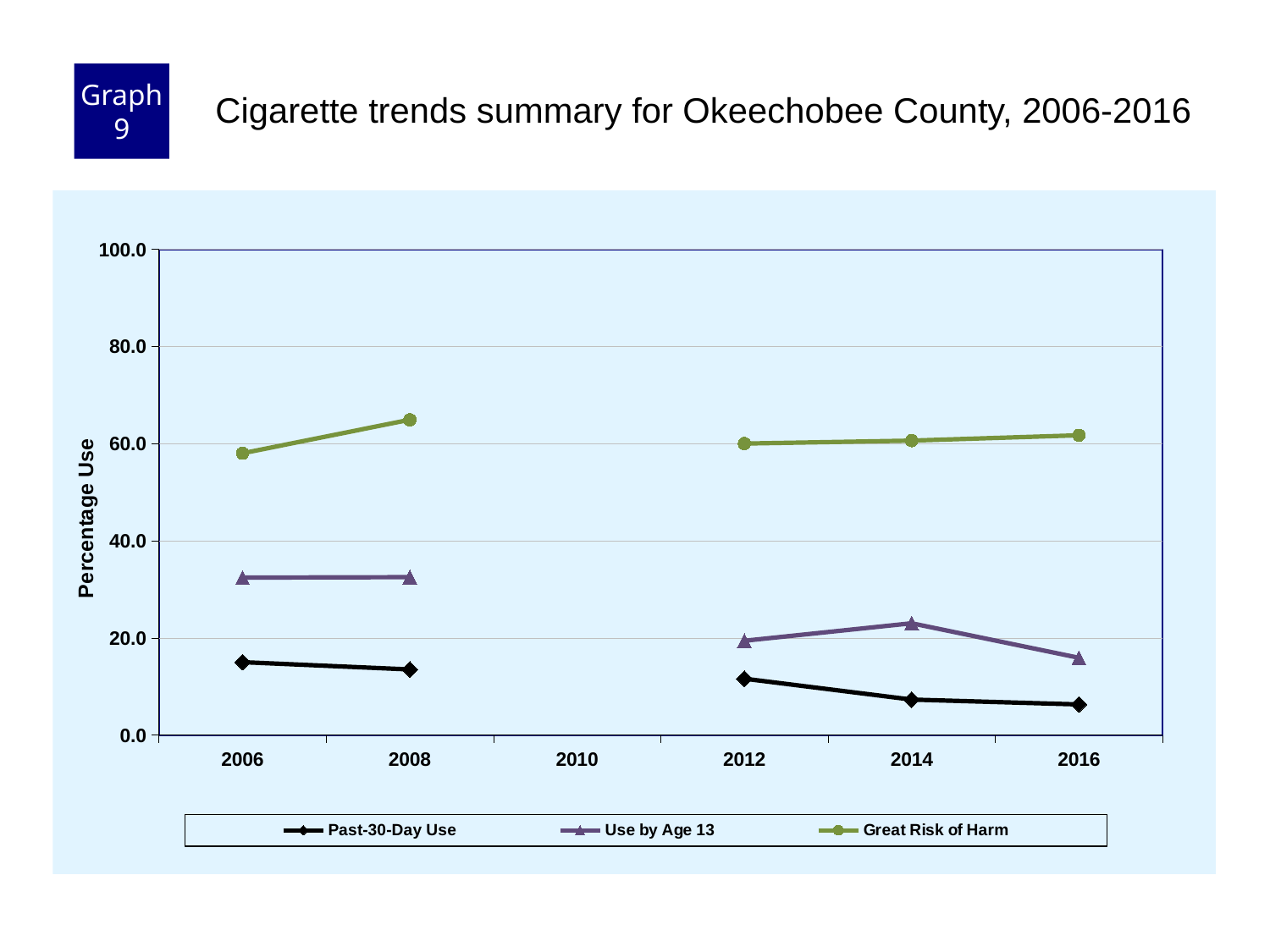
Is the value for Great Risk of Harm in 2008 greater or less than 60.0? greater Is the value for Past-30-Day Use in 2014 greater or less than 20.0? less Which series has the lowest values across all years shown? Past-30-Day Use What kind of chart is shown on the slide? line chart Is the value for Use by Age 13 in 2006 greater or less than 20.0? greater Which series has the highest values across all years shown? Great Risk of Harm Which is larger, Use by Age 13 in 2014 or Use by Age 13 in 2016? 2014 What is the label on the vertical axis? Percentage Use What is the title of the chart? Cigarette trends summary for Okeechobee County, 2006-2016 Does Past-30-Day Use rise or fall from 2012 to 2016? fall How many series does the legend list? 3